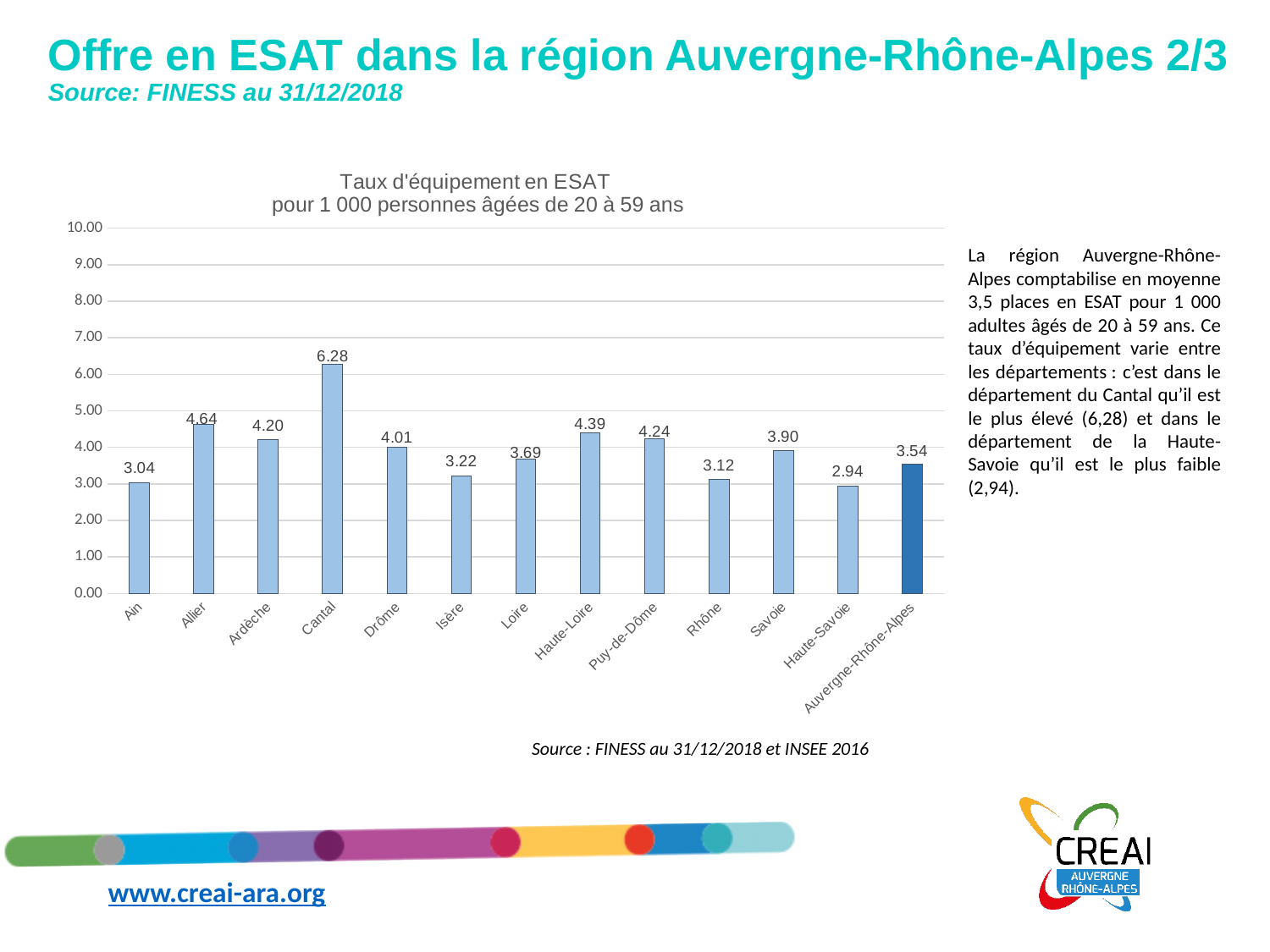
Is the value for Savoie greater or less than 3.00? greater Which is larger, the value for Allier or the value for Haute-Loire? Allier What kind of chart is shown? Bar chart What is the value for Auvergne-Rhône-Alpes? 3.54 What is the value for Haute-Savoie? 2.94 Which category has the lowest value? Haute-Savoie What is the value for Rhône? 3.12 Which category has the highest value? Cantal What is the difference between the values for Cantal and Haute-Savoie? 3.34 How many categories are shown on the x axis? 13 What is the title of the chart? Taux d'équipement en ESAT pour 1 000 personnes âgées de 20 à 59 ans What is the value for Cantal? 6.28